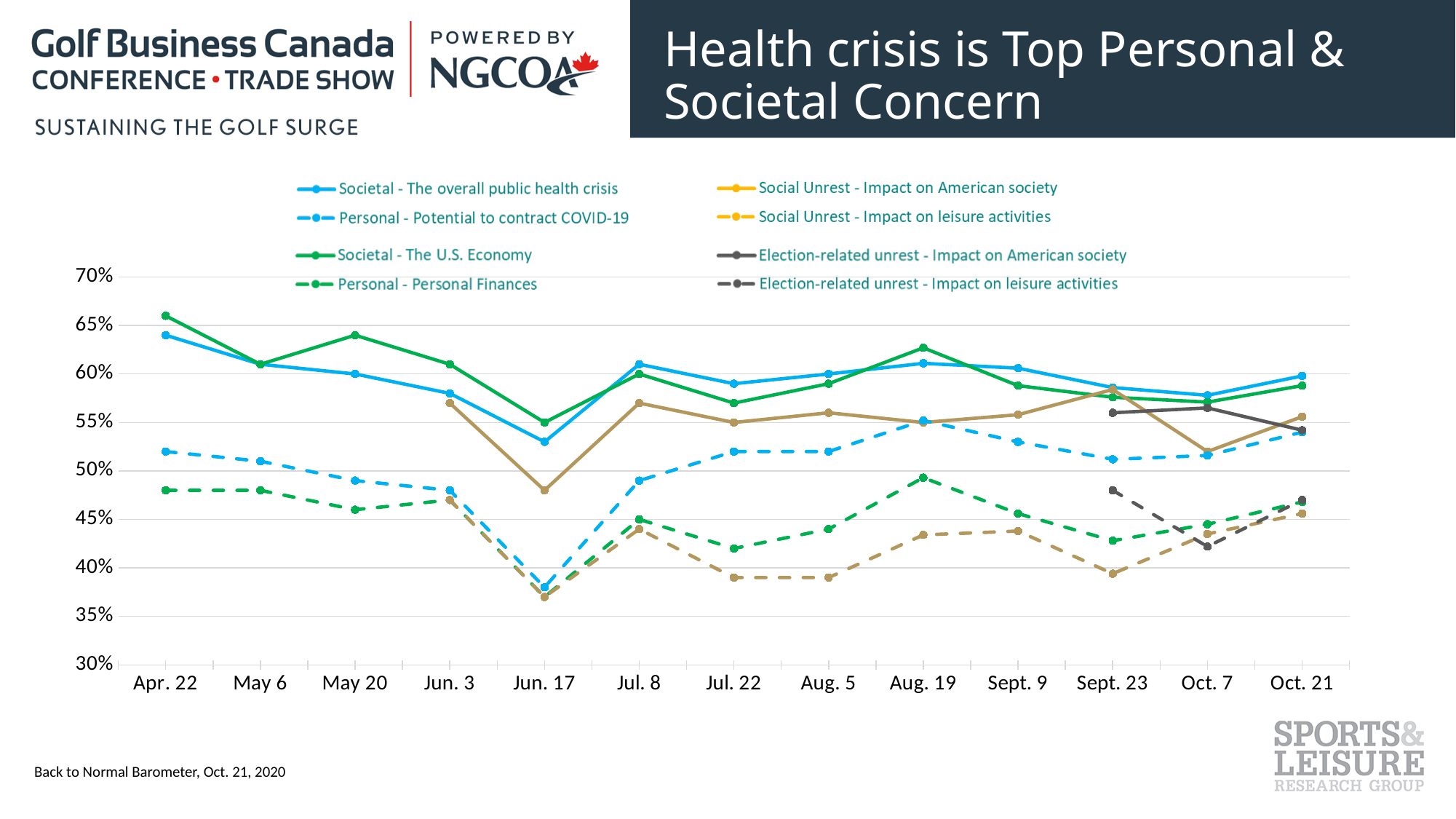
Is the value for Societal - The overall public health crisis on Jun. 17 greater or less than 50%? greater On which date does Personal - Potential to contract COVID-19 reach its lowest value? Jun. 17 Does Personal - Potential to contract COVID-19 rise or fall from Apr. 22 to Jun. 17? fall How many dates are shown along the x axis? 13 How many series does the legend list? 8 Is the value for Societal - The U.S. Economy on Apr. 22 greater or less than 65%? greater What kind of chart is shown on the slide? line chart Is the value for Personal - Potential to contract COVID-19 on Jun. 17 greater or less than 40%? less Which series has the highest value on Apr. 22? Societal - The U.S. Economy On Jun. 17, which is higher: Societal - The overall public health crisis or Societal - The U.S. Economy? Societal - The U.S. Economy What is the title of the slide containing the chart? Health crisis is Top Personal & Societal Concern